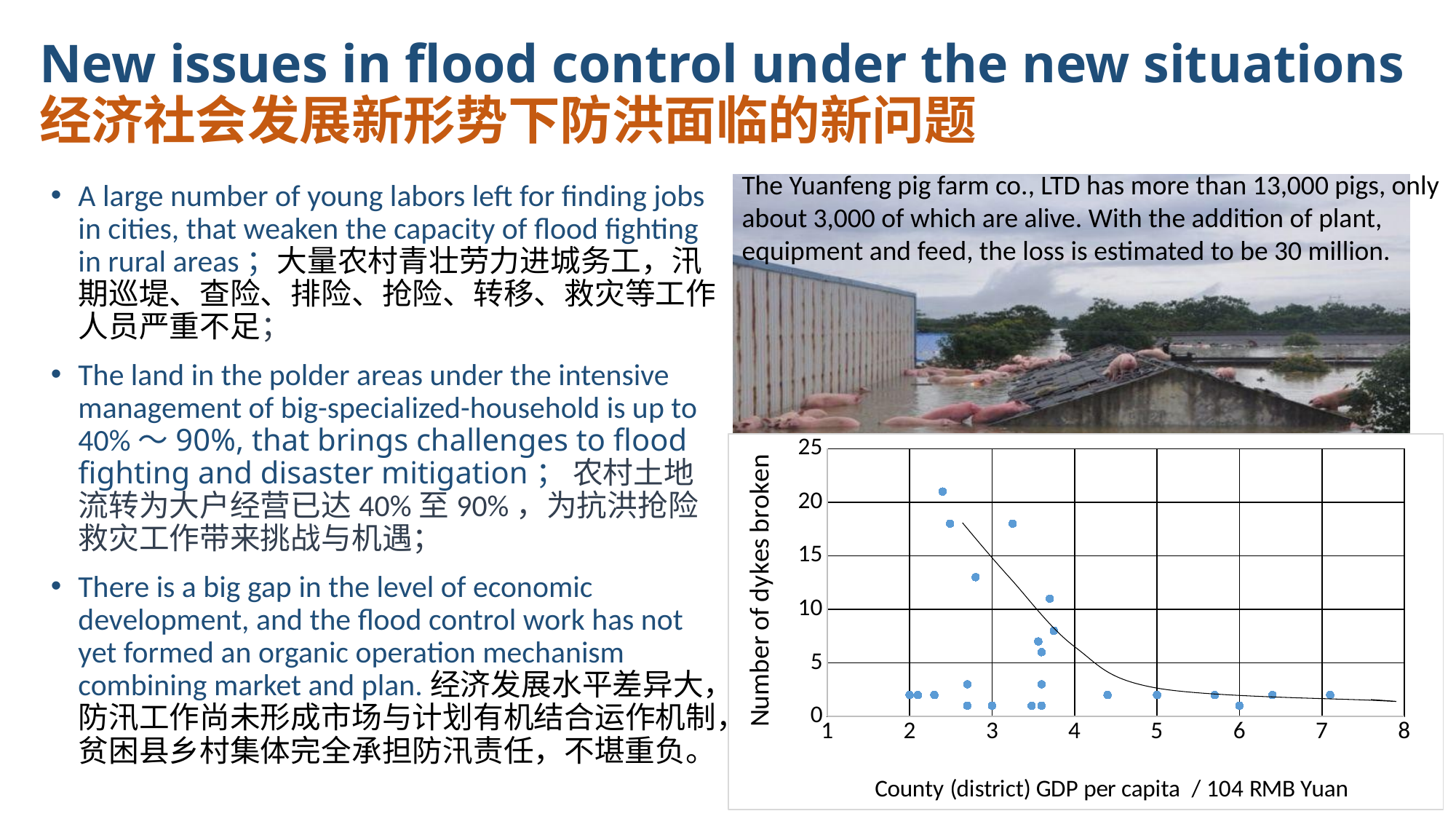
Which has more dykes broken: the point at GDP per capita of about 2.4 or the point at about 7? the point at about 2.4 What is the label of the vertical axis of the chart? Number of dykes broken What kind of chart is shown on the slide? scatter chart Is the number of dykes broken for the point at GDP per capita of about 7 greater or less than 5? less Is the number of dykes broken for the point at GDP per capita of about 2.8 greater or less than 10? greater Is the number of dykes broken for the point at GDP per capita of about 3.25 greater or less than 15? greater What is the label of the horizontal axis of the chart? County (district) GDP per capita / 104 RMB Yuan According to the fitted line, does the number of dykes broken rise or fall as GDP per capita increases? fall